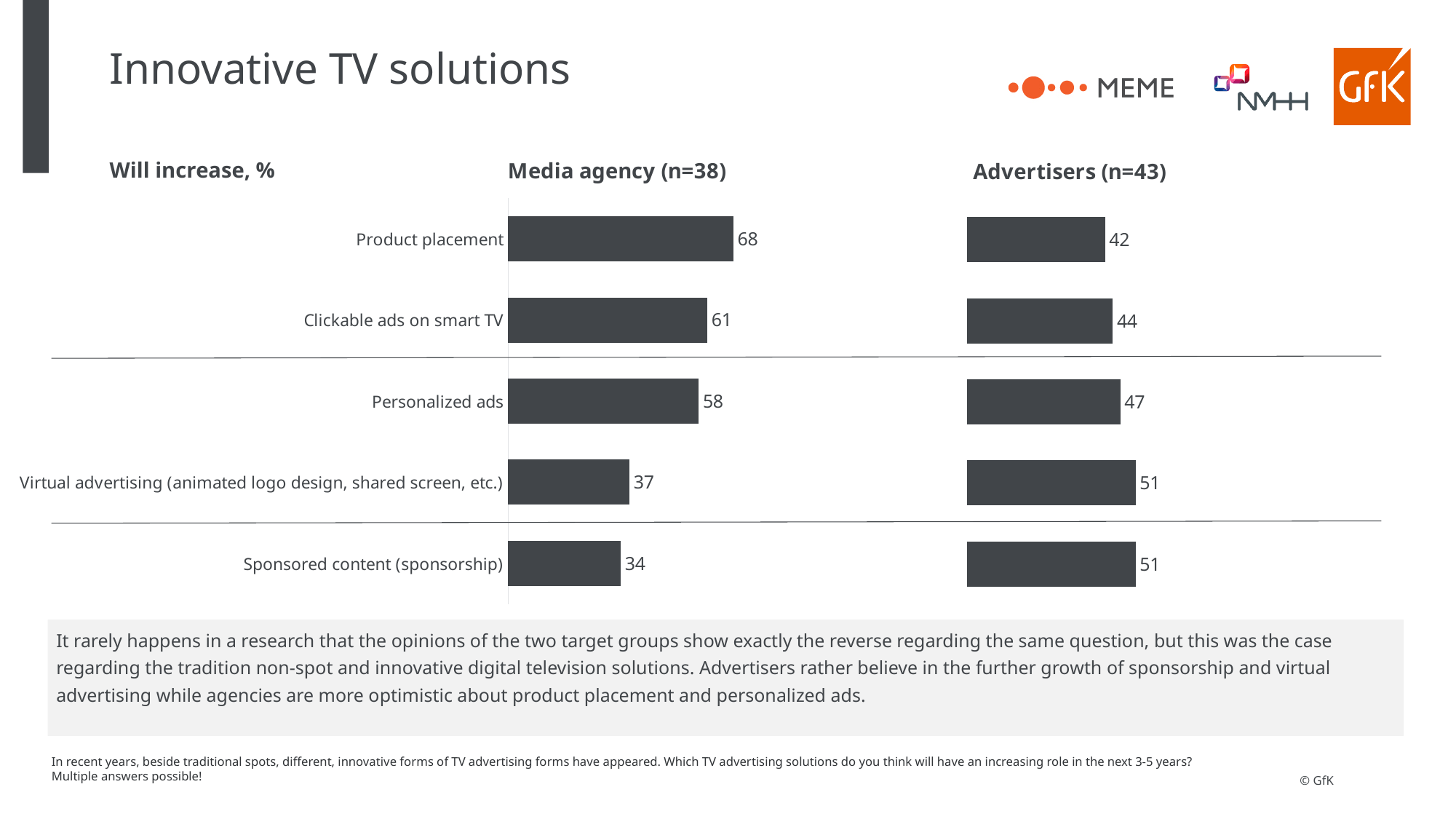
For Personalized ads, which is larger: the Media agency value or the Advertisers value? Media agency For Sponsored content (sponsorship), which is larger: the Media agency value or the Advertisers value? Advertisers In the Media agency (n=38) chart, which category has the lowest value? Sponsored content (sponsorship) In the Advertisers (n=43) chart, what is the value for Personalized ads? 47 In the Media agency (n=38) chart, what is the difference between Product placement and Sponsored content (sponsorship)? 34 In the Advertisers (n=43) chart, which category has the lowest value? Product placement In the Media agency (n=38) chart, which category has the highest value? Product placement In the Advertisers (n=43) chart, what is the value for Clickable ads on smart TV? 44 How many categories are shown in the Media agency (n=38) chart? 5 What is the difference between the Media agency and Advertisers values for Virtual advertising (animated logo design, shared screen, etc.)? 14 What type of chart is used for the Advertisers (n=43) data? Bar chart In the Media agency (n=38) chart, what is the value for Product placement? 68